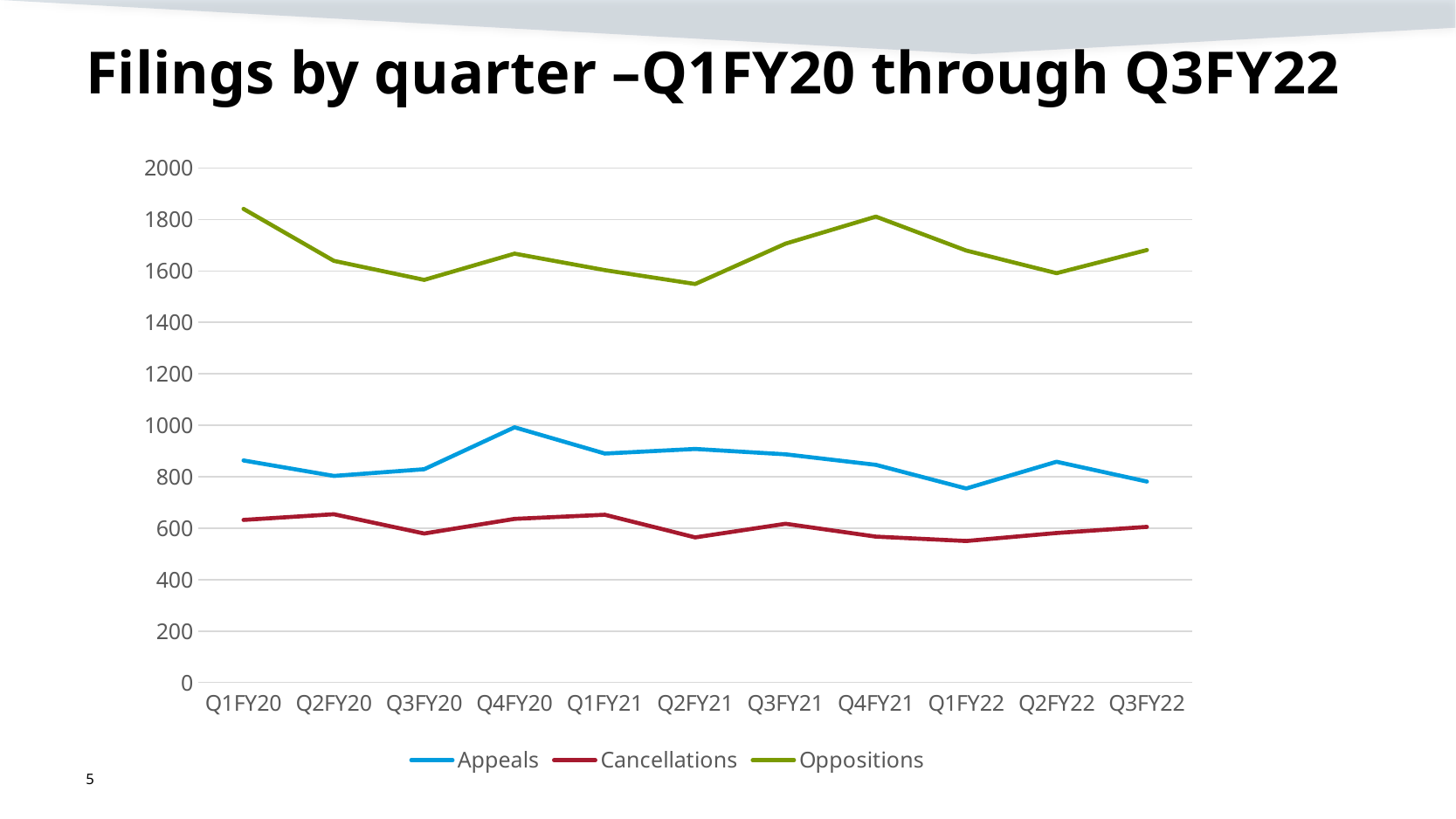
Which is larger for Oppositions: the value in Q4FY21 or the value in Q2FY22? Q4FY21 How many quarters are plotted along the x axis? 11 Is the value for Cancellations in Q3FY20 greater or less than 600? less In which quarter is the Appeals series at its lowest? Q1FY22 In which quarter is the Appeals series at its highest? Q4FY20 Is the value for Oppositions in Q1FY20 greater or less than 1800? greater Which series has the highest values across all quarters? Oppositions How many series does the legend list? 3 Is the value for Oppositions in Q2FY21 greater or less than 1600? less What kind of chart is shown on the slide? Line chart What is the title of the chart on the slide? Filings by quarter –Q1FY20 through Q3FY22